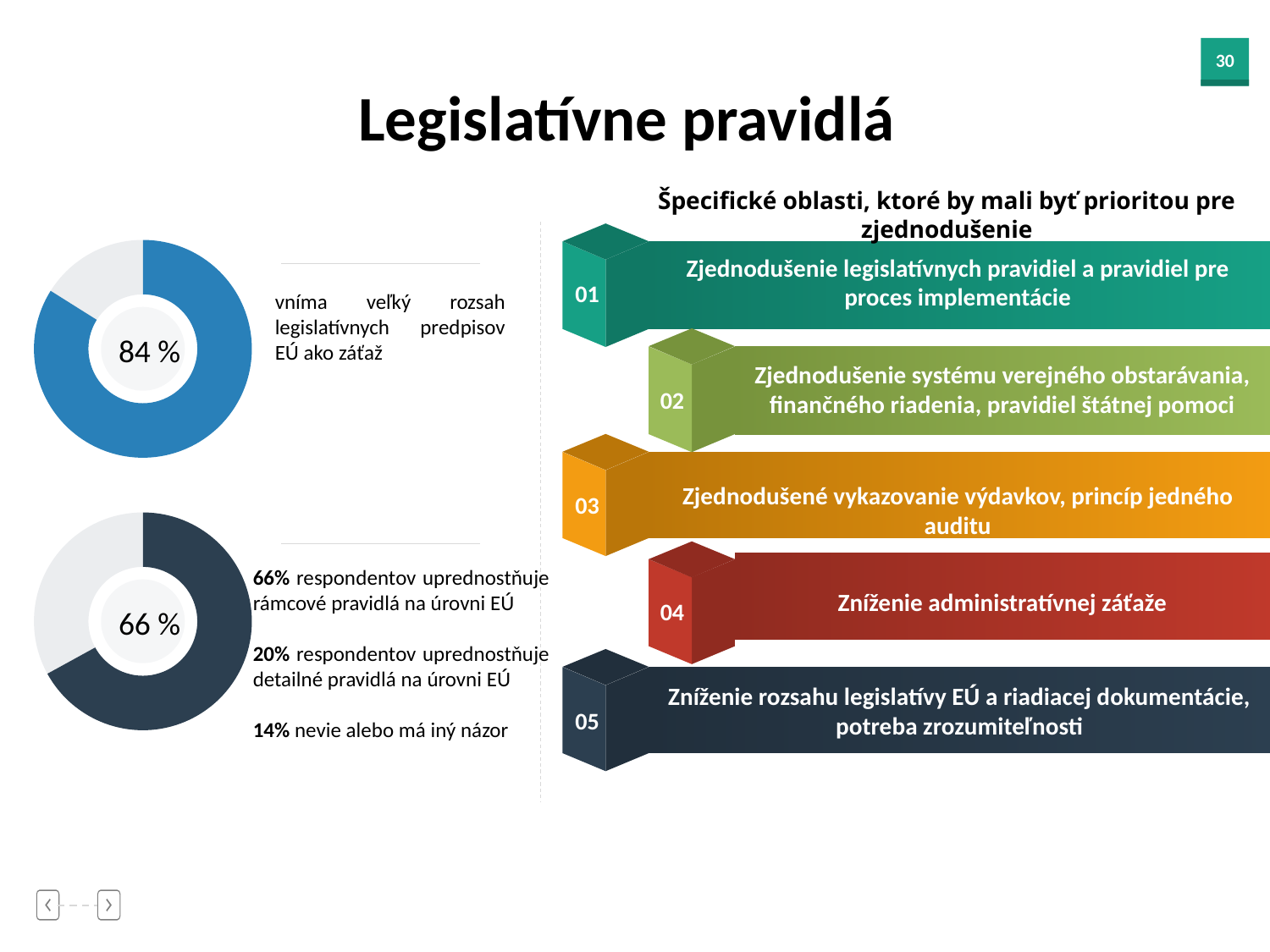
Is the highlighted share in the bottom donut chart greater or less than 75%? less What value is printed in the centre of the top donut chart? 84 % What kind of chart is the top chart on the left side of the slide? Donut chart Which donut chart shows the larger highlighted share, the top one or the bottom one? The top one What colour is the highlighted segment of the top donut chart? Blue What is the difference between the value in the top donut chart and the value in the bottom donut chart? 18 % Is the highlighted share in the top donut chart greater or less than 50%? greater According to the text next to the bottom donut chart, what percentage of respondents prefer detailed rules at EU level? 20% How many donut charts are shown on the slide? 2 What kind of chart is the bottom chart on the left side of the slide? Donut chart What value is printed in the centre of the bottom donut chart? 66 % What colour is the highlighted segment of the bottom donut chart? Dark blue-grey